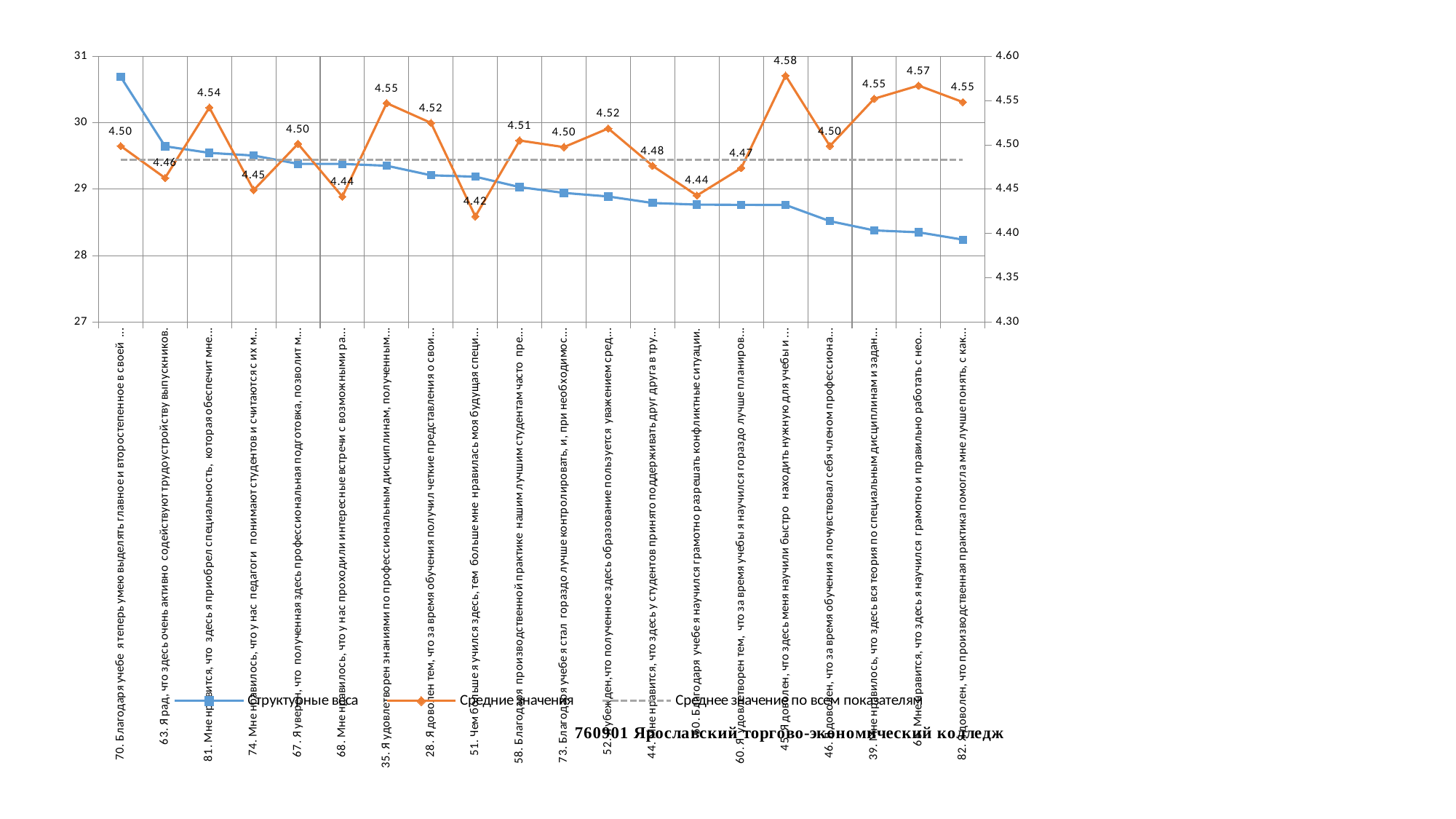
Which item has the lowest value in the "Средние значения" series? 51. Чем больше я учился здесь, тем больше мне нравилась моя будущая специ... (4.42) How many categories (items) are plotted along the x axis? 20 What is the difference between the highest and lowest values of the "Средние значения" series? 0.16 Is the "Структурные веса" value for item 70 (the first category) greater or less than 30 on the left axis? greater How many series does the legend list? 3 Does the "Структурные веса" series generally rise or fall from left to right along the x axis? Fall Which item has the highest value in the "Средние значения" series? 45. Я доволен, что здесь меня научили быстро находить нужную для учебы и ... (4.58) What is the value of the "Средние значения" series for item 50 ("Благодаря учебе я научился грамотно разрешать конфликтные ситуации")? 4.44 In the "Средние значения" series, which is larger: the value for item 81 or the value for item 74? Item 81 (4.54) What kind of chart is shown on the slide? Line chart What is the value of the "Средние значения" series for item 63 ("Я рад, что здесь очень активно содействуют трудоустройству выпускников")? 4.46